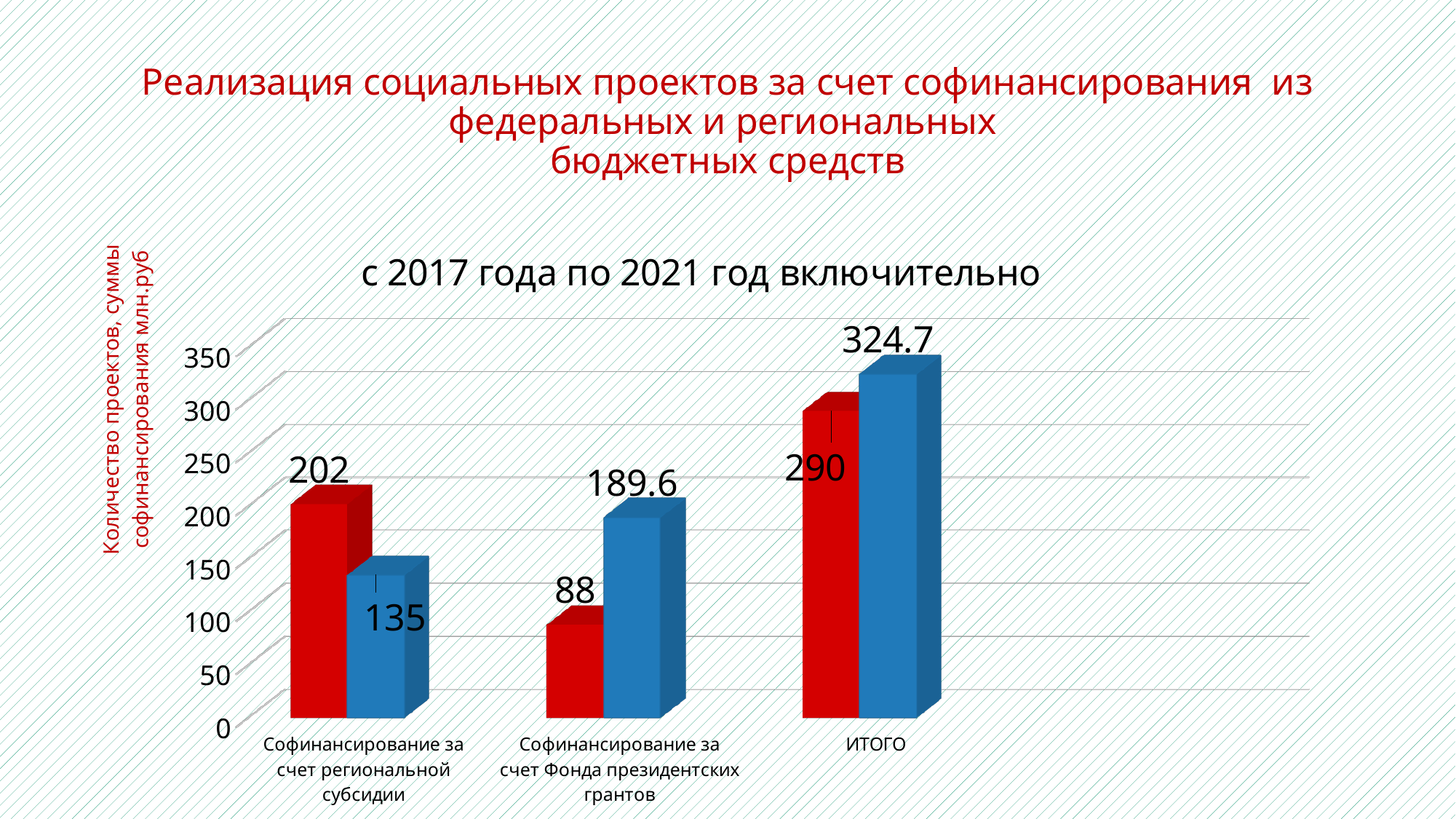
What kind of chart is shown on the slide? bar chart What is the difference between the blue bar values for «ИТОГО» and «Софинансирование за счет Фонда президентских грантов»? 135.1 What is the value of the blue bar for «Софинансирование за счет Фонда президентских грантов»? 189.6 What is the value of the red bar for «Софинансирование за счет региональной субсидии»? 202 What is the title printed directly above the chart? с 2017 года по 2021 год включительно Which category has the highest blue bar? ИТОГО How many categories are shown on the x axis? 3 For «Софинансирование за счет региональной субсидии», which bar is larger, the red one or the blue one? the red one What is the value of the red bar for «Софинансирование за счет Фонда президентских грантов»? 88 Which category has the lowest red bar? Софинансирование за счет Фонда президентских грантов What is the difference between the red bar values for «Софинансирование за счет региональной субсидии» and «Софинансирование за счет Фонда президентских грантов»? 114 What is the value of the blue bar for «ИТОГО»? 324.7